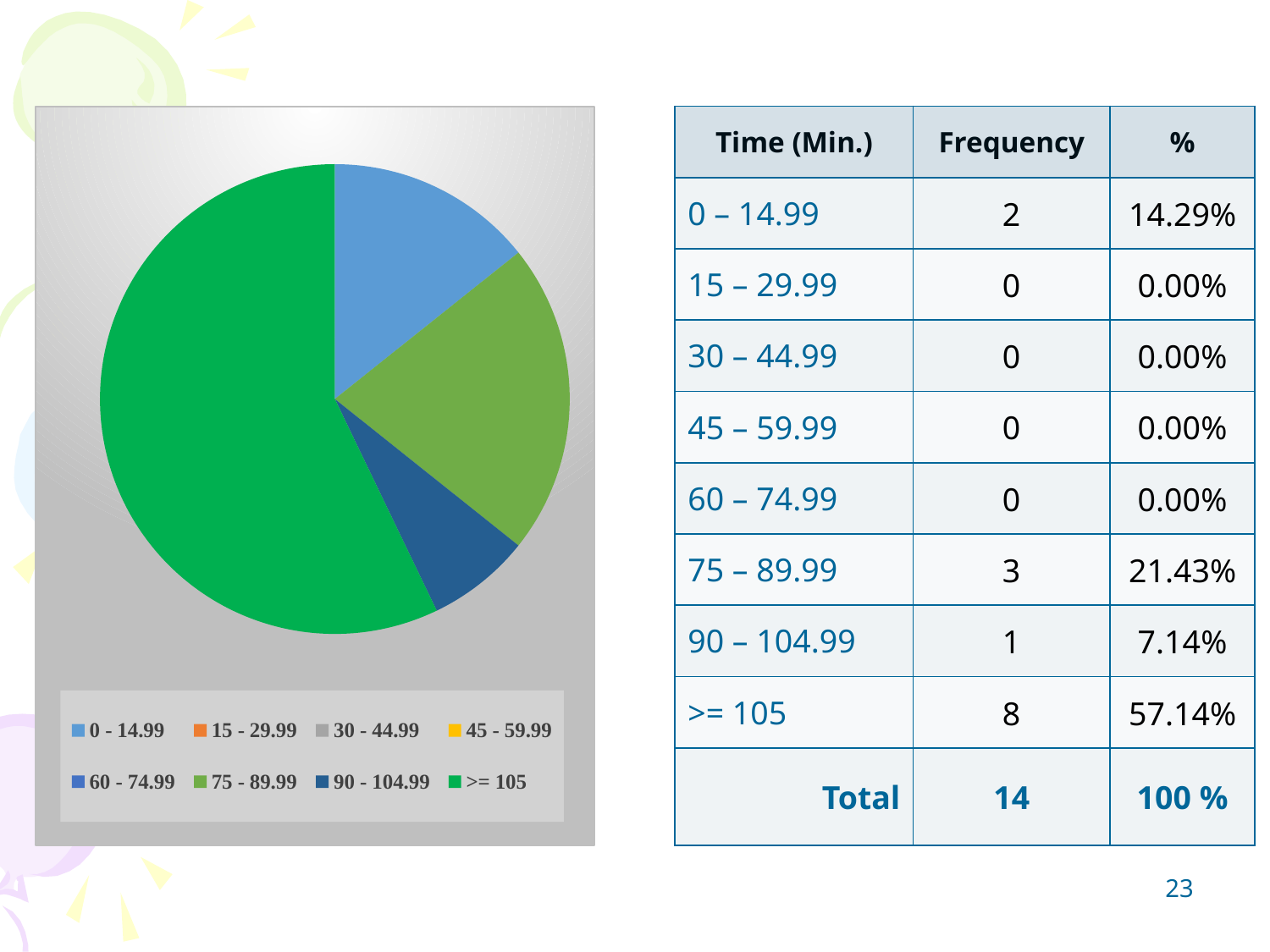
How many slices are visible in the pie chart? 4 According to the table on the slide, what share of the pie does the >= 105 category represent? 57.14% What colour is the slice for the >= 105 category in the pie chart? green Which of the visible slices is the smallest in the pie chart? 90 - 104.99 Which category has the largest slice of the pie chart? >= 105 According to the table on the slide, what is the frequency for the 75 - 89.99 category? 3 How many categories does the pie chart's legend list? 8 What kind of chart is shown on the slide? pie chart Is the slice for 75 - 89.99 larger or smaller than the slice for 0 - 14.99? larger According to the table on the slide, what is the total frequency across all categories? 14 Is the slice for >= 105 larger or smaller than the slice for 90 - 104.99? larger According to the table on the slide, what share of the pie does the 0 - 14.99 category represent? 14.29%